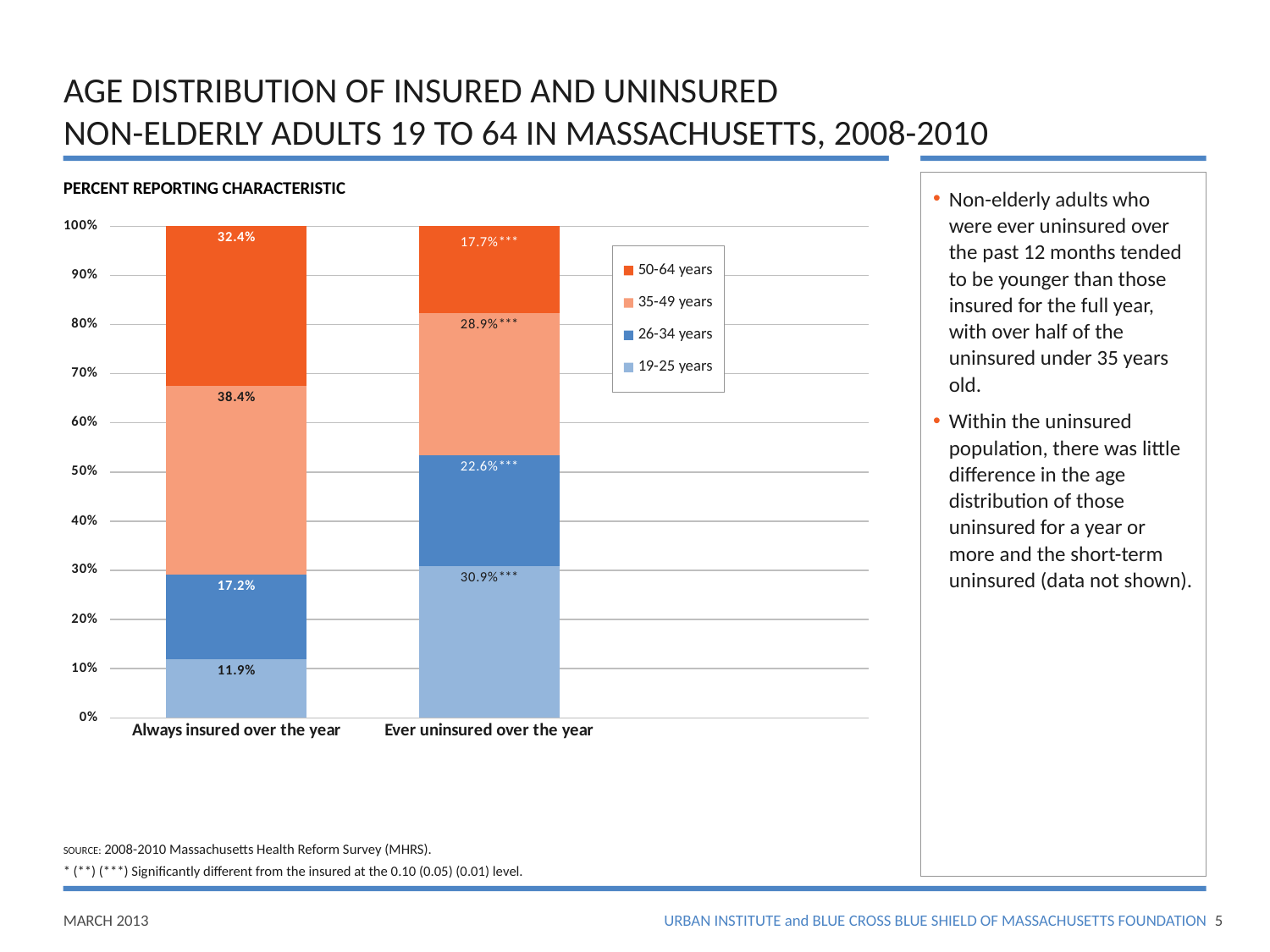
How many categories are shown on the x axis? 2 Which age group is the largest among adults always insured over the year? 35-49 years What kind of chart is shown on the slide? Stacked bar chart What percentage of adults ever uninsured over the year were aged 35-49 years? 28.9% What is the difference between the 19-25 years share for ever uninsured and always insured adults? 19.0 percentage points How many series does the legend list? 4 What is the combined share of adults under 35 years old (19-25 and 26-34) among those ever uninsured over the year? 53.5% What percentage of adults ever uninsured over the year were aged 19-25 years? 30.9% What percentage of adults always insured over the year were aged 50-64 years? 32.4% What percentage of adults always insured over the year were aged 26-34 years? 17.2% Which group has a larger share of 50-64 year olds: always insured or ever uninsured over the year? Always insured over the year Which age group is the smallest among adults ever uninsured over the year? 50-64 years